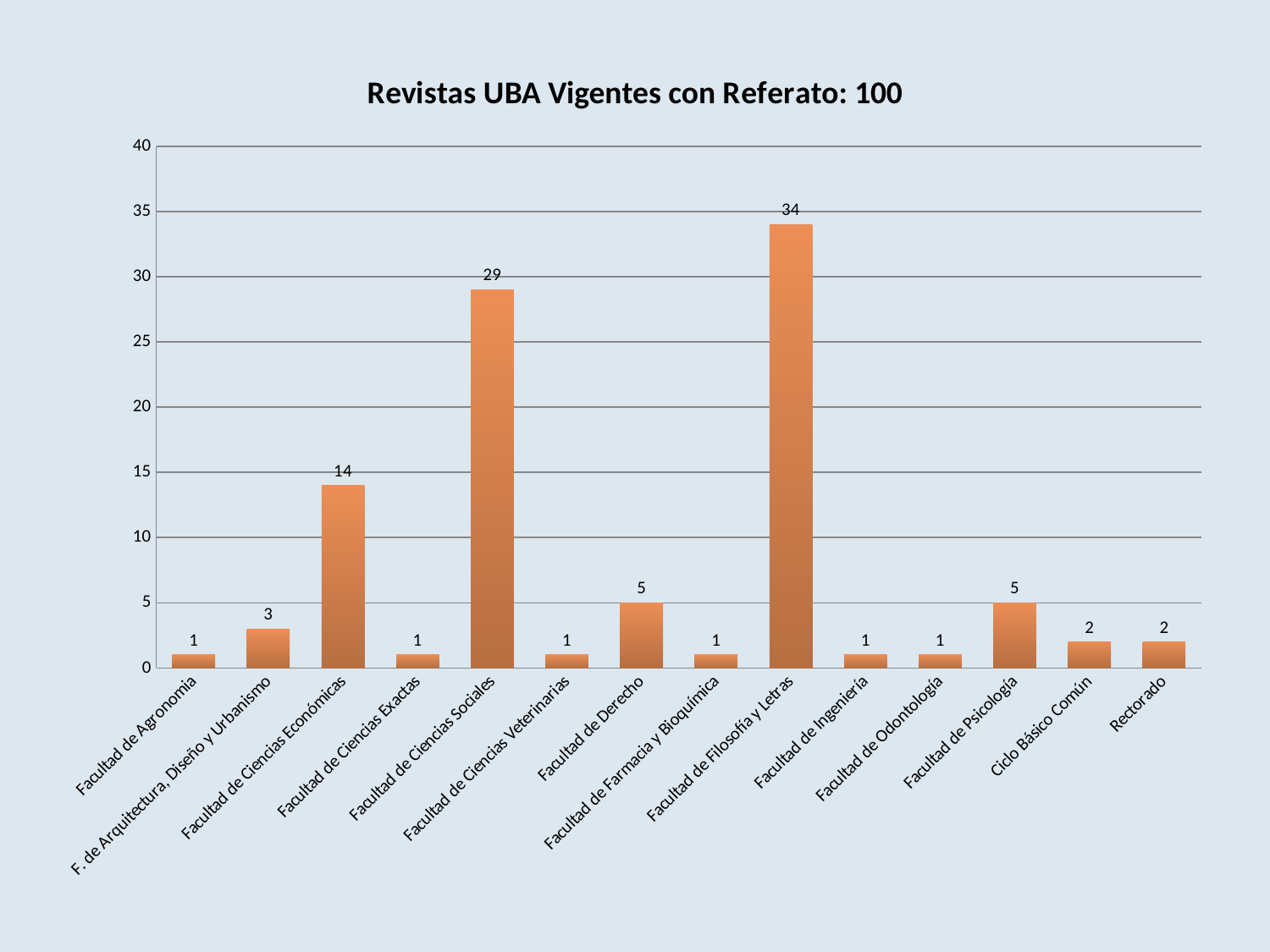
How many categories are shown on the x axis? 14 What is the value for Facultad de Derecho? 5 What is the value for Facultad de Ciencias Sociales? 29 Which is larger, the value for Facultad de Ciencias Económicas or the value for Facultad de Psicología? Facultad de Ciencias Económicas Is the value for Facultad de Ciencias Sociales greater or less than 25? greater What kind of chart is shown on the slide? bar chart Which category has the highest value? Facultad de Filosofía y Letras What is the value for Facultad de Ciencias Económicas? 14 What is the difference between the values for Facultad de Filosofía y Letras and Facultad de Ciencias Sociales? 5 What is the value for Facultad de Filosofía y Letras? 34 What is the title of the chart? Revistas UBA Vigentes con Referato: 100 What is the value for Ciclo Básico Común? 2